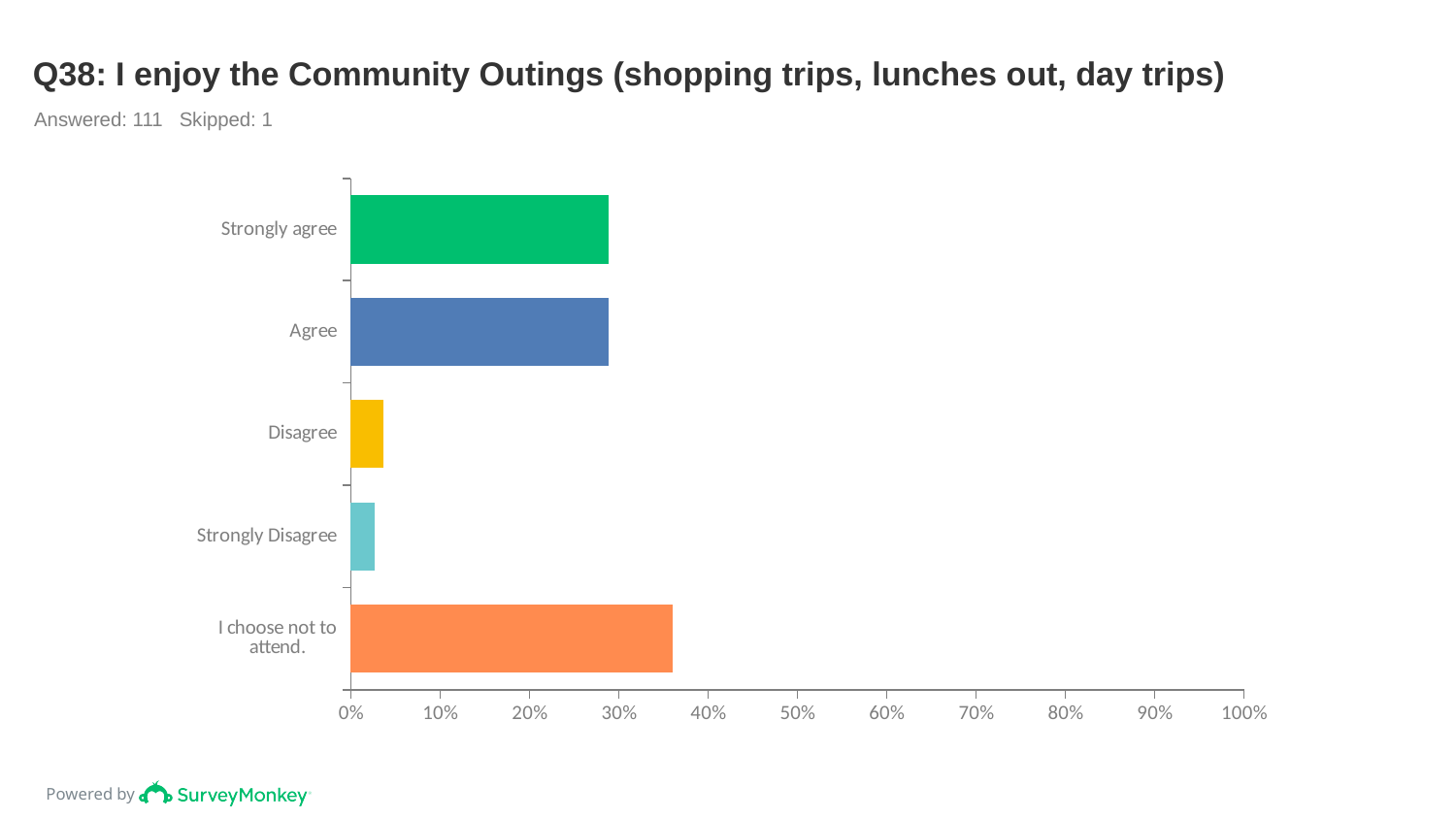
How many response categories are shown in the chart? 5 Which response category has the highest percentage? I choose not to attend. Is the value for "I choose not to attend." greater or less than 30%? greater Which is larger, the value for "Strongly agree" or the value for "Disagree"? Strongly agree What kind of chart is shown on the slide? bar chart Is the value for "I choose not to attend." greater or less than 40%? less Is the value for "Strongly Disagree" greater or less than 10%? less Which is larger, the value for "I choose not to attend." or the value for "Agree"? I choose not to attend. How many respondents answered this question according to the slide? 111